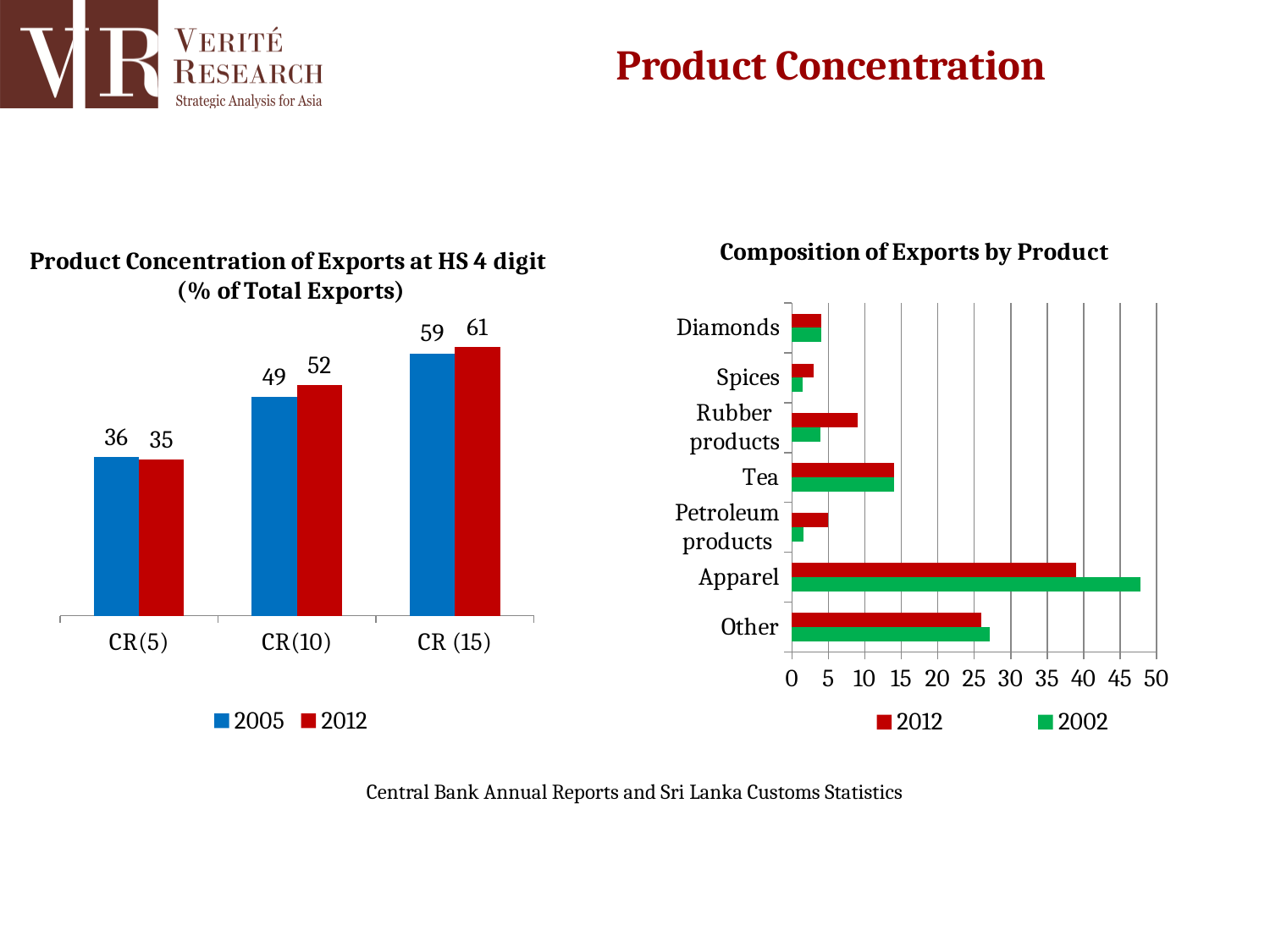
In the chart 'Product Concentration of Exports at HS 4 digit', how many series does the legend list? 2 In the chart 'Product Concentration of Exports at HS 4 digit', which is larger for CR(5): the 2005 value or the 2012 value? 2005 In the chart 'Product Concentration of Exports at HS 4 digit', what is the 2005 value for CR(5)? 36 What kind of chart is 'Composition of Exports by Product'? Bar chart In the chart 'Product Concentration of Exports at HS 4 digit', what is the difference between the 2012 and 2005 values for CR (15)? 2 In the chart 'Product Concentration of Exports at HS 4 digit', which category has the highest 2012 value? CR (15) In the chart 'Composition of Exports by Product', is the 2012 value for Tea greater or less than 15? less In the chart 'Composition of Exports by Product', how many product categories are shown? 7 In the chart 'Composition of Exports by Product', which series is shown in green? 2002 In the chart 'Composition of Exports by Product', is the 2002 value for Apparel greater or less than 45? greater In the chart 'Composition of Exports by Product', which product has the highest 2002 value? Apparel In the chart 'Product Concentration of Exports at HS 4 digit', what is the 2012 value for CR(10)? 52